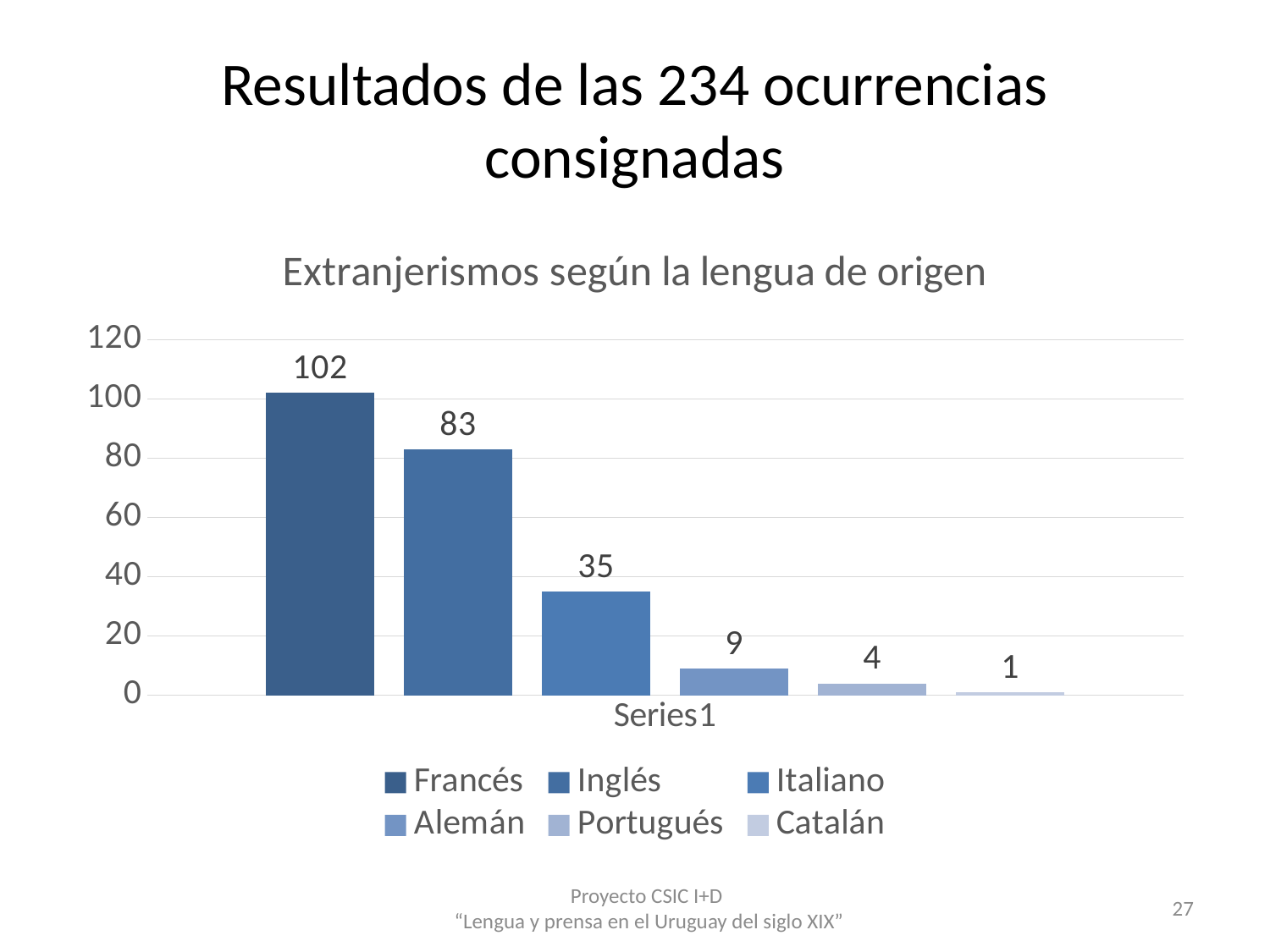
Which is larger, the value for Italiano or the value for Portugués? Italiano What is the value for Alemán? 9 What is the value for Italiano? 35 What kind of chart is shown on the slide? bar chart What is the title of the chart? Extranjerismos según la lengua de origen What is the difference between the values for Francés and Inglés? 19 Is the value for Inglés greater or less than 80? greater Which language has the lowest value? Catalán How many languages are shown in the chart? 6 What is the value for Francés? 102 What is the value for Inglés? 83 Which language has the highest value? Francés